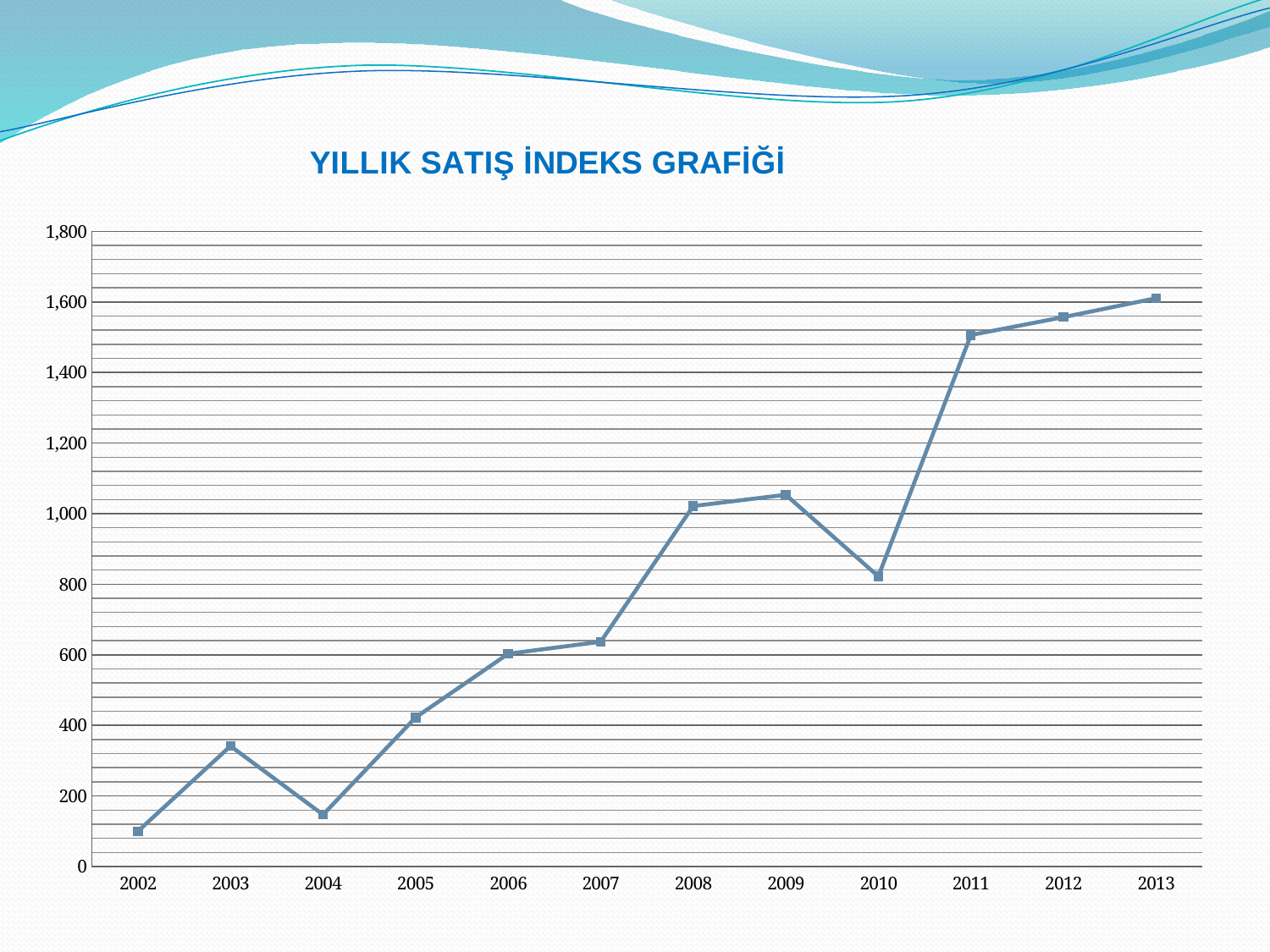
Which year has the lowest value? 2002 Is the value for 2002 greater or less than 200? less Overall, do the values rise or fall from 2002 to 2013? rise Is the value for 2011 greater or less than 1,400? greater Which year has the larger value, 2008 or 2010? 2008 Which year has the highest value? 2013 What is the title of the chart? YILLIK SATIŞ İNDEKS GRAFİĞİ Is the value for 2010 greater or less than 1,000? less What kind of chart is shown on the slide? line chart How many years are plotted on the x axis? 12